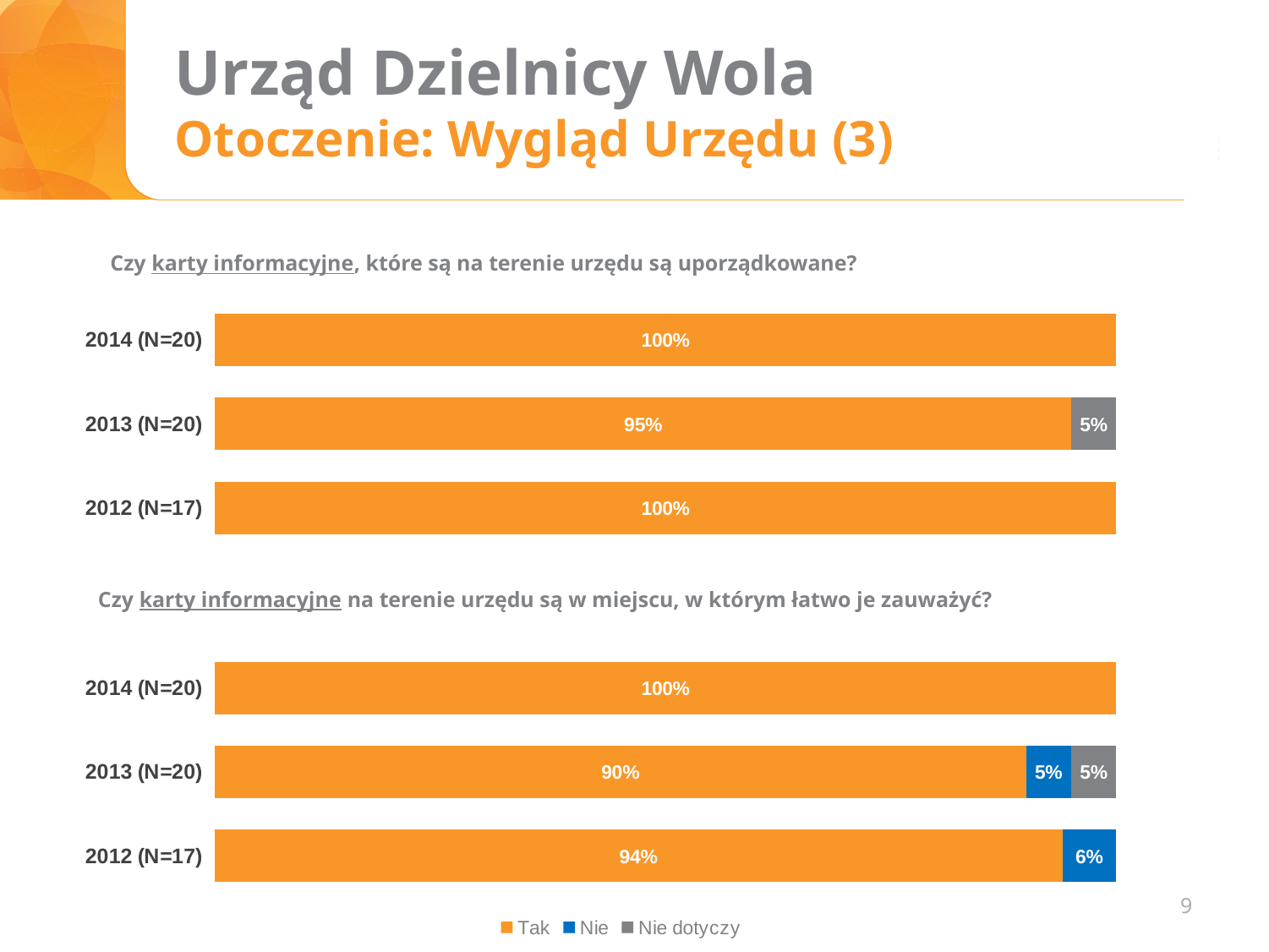
In the bottom chart ("Czy karty informacyjne na terenie urzędu są w miejscu, w którym łatwo je zauważyć?"), what is the difference between the "Tak" values for 2012 (N=17) and 2013 (N=20)? 4% In the bottom chart ("Czy karty informacyjne na terenie urzędu są w miejscu, w którym łatwo je zauważyć?"), what is the "Tak" value for 2013 (N=20)? 90% In the bottom chart ("Czy karty informacyjne na terenie urzędu są w miejscu, w którym łatwo je zauważyć?"), what is the total of the stacked bar for 2013 (N=20)? 100% In the top chart ("Czy karty informacyjne, które są na terenie urzędu są uporządkowane?"), which is larger: the "Tak" value for 2014 (N=20) or for 2013 (N=20)? 2014 (N=20) How many year categories does the bottom chart ("Czy karty informacyjne na terenie urzędu są w miejscu, w którym łatwo je zauważyć?") show? 3 In the bottom chart ("Czy karty informacyjne na terenie urzędu są w miejscu, w którym łatwo je zauważyć?"), what is the "Nie" value for 2012 (N=17)? 6% What are the three legend entries shown at the bottom of the slide? Tak, Nie, Nie dotyczy What type of chart is the top chart ("Czy karty informacyjne, które są na terenie urzędu są uporządkowane?")? Stacked bar chart In the top chart ("Czy karty informacyjne, które są na terenie urzędu są uporządkowane?"), what is the "Nie dotyczy" value for 2013 (N=20)? 5% In the top chart ("Czy karty informacyjne, które są na terenie urzędu są uporządkowane?"), what is the "Tak" value for 2013 (N=20)? 95% In the bottom chart ("Czy karty informacyjne na terenie urzędu są w miejscu, w którym łatwo je zauważyć?"), which year has the lowest "Tak" value? 2013 (N=20) How many series does the legend at the bottom of the slide list? 3